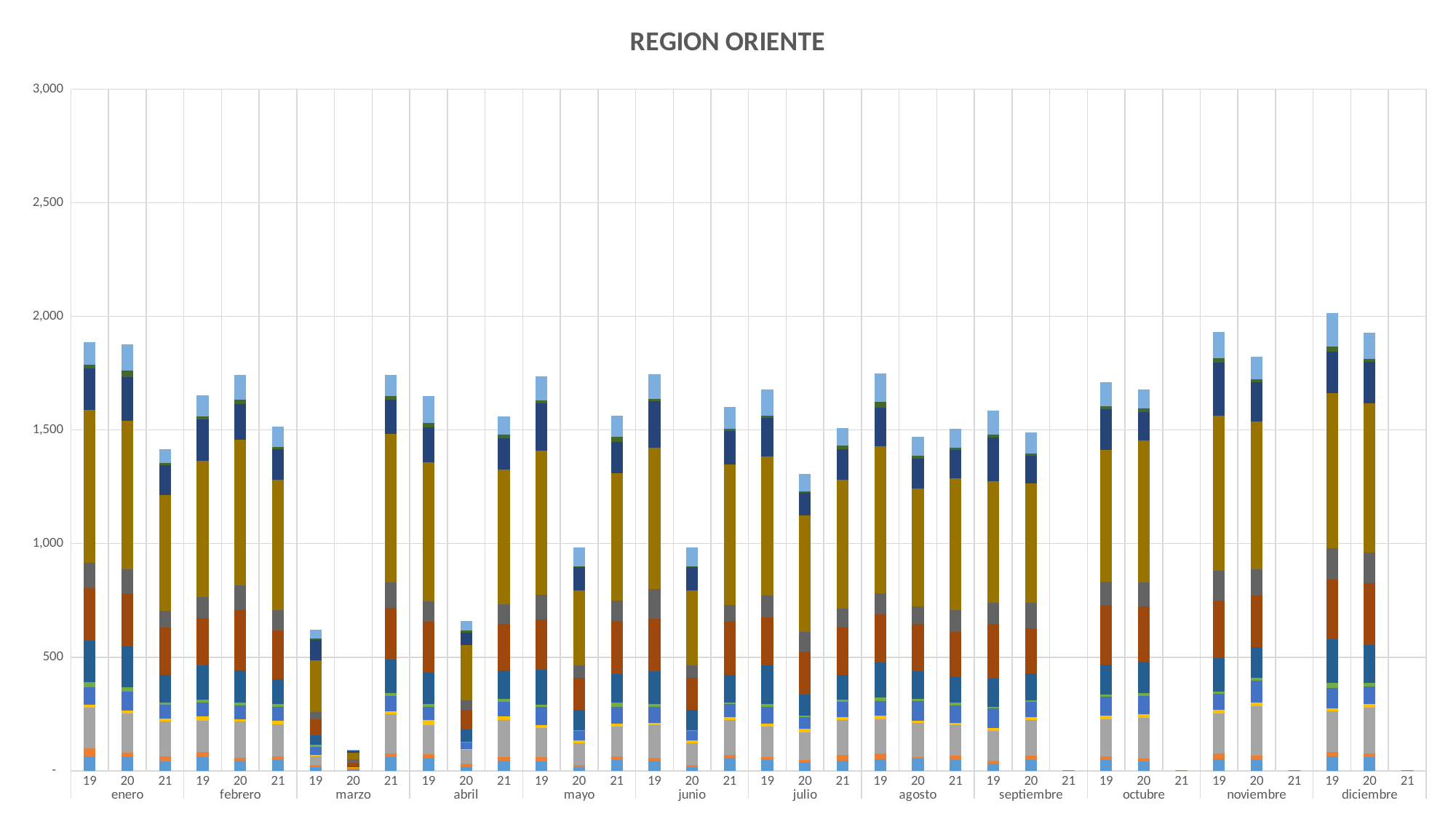
Is the total for julio 20 greater or less than 1,500? less Which bar is the tallest in the chart? diciembre 19 What is the title of the chart? REGION ORIENTE Is the total for enero 19 greater or less than 1,500? greater Which bar is taller, enero 19 or enero 21? enero 19 Which bar is taller, marzo 20 or marzo 21? marzo 21 What kind of chart is shown on the slide? Stacked bar chart Among the bars labelled 20, which month has the lowest total? marzo What is the highest value shown on the vertical axis? 3,000 Is the total for marzo 19 greater or less than 1,000? less How many month groups are shown along the x axis? 12 How many bars (year sub-categories) are shown in each month group? 3